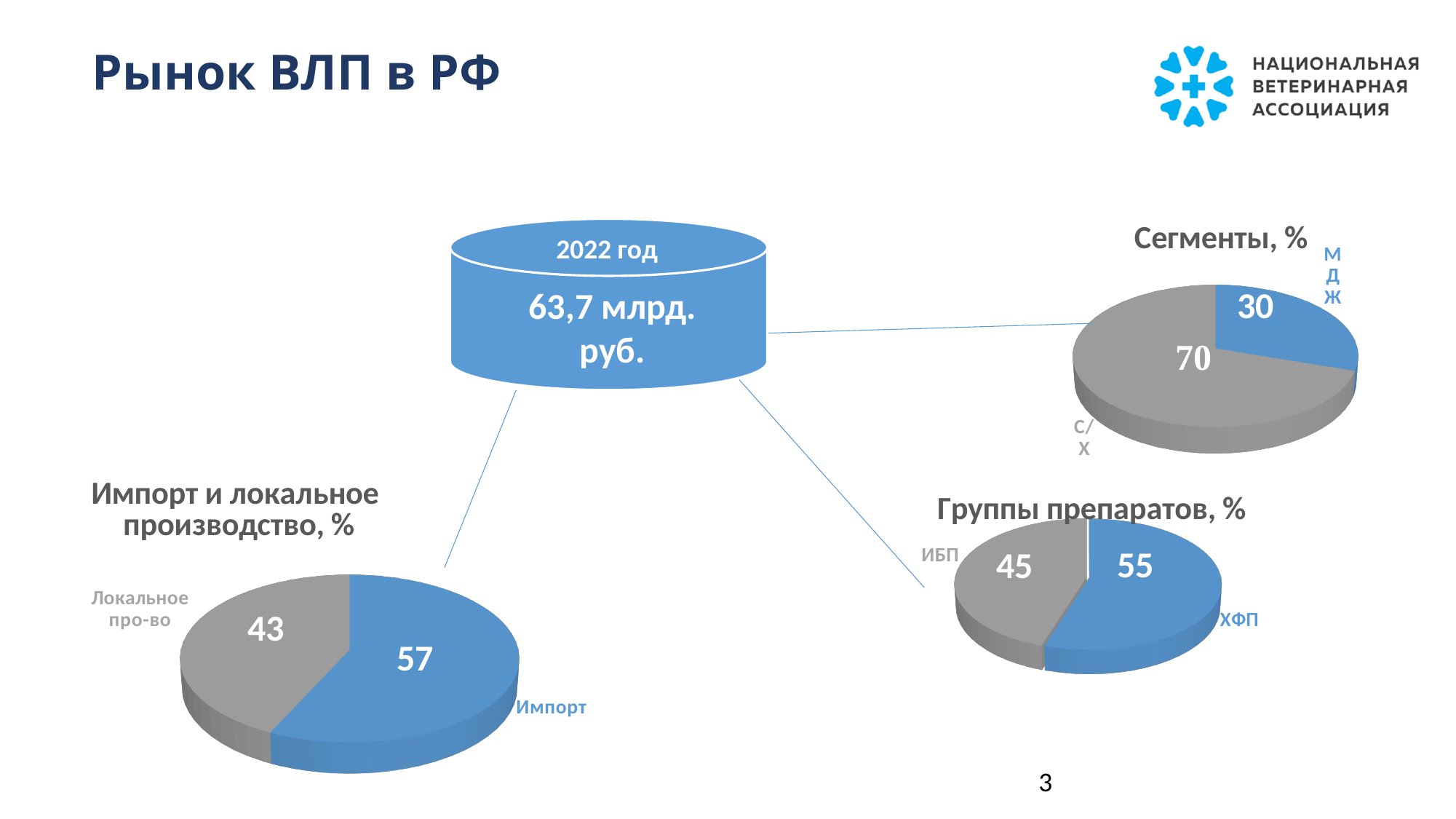
In the 'Группы препаратов, %' chart, what is the value for ХФП? 55 In the 'Группы препаратов, %' chart, which group is the smallest? ИБП In the 'Сегменты, %' chart, what is the value for С/Х? 70 In the 'Сегменты, %' chart, what is the value for МДЖ? 30 In the 'Импорт и локальное производство, %' chart, which is larger, Импорт or Локальное про-во? Импорт What kind of chart is 'Группы препаратов, %'? Pie chart In the 'Группы препаратов, %' chart, what is the value for ИБП? 45 In the 'Сегменты, %' chart, what is the difference between С/Х and МДЖ? 40 In the 'Импорт и локальное производство, %' chart, what is the value for Локальное про-во? 43 In the 'Импорт и локальное производство, %' chart, what is the difference between Импорт and Локальное про-во? 14 In the 'Импорт и локальное производство, %' chart, what is the value for Импорт? 57 In the 'Сегменты, %' chart, which segment is the largest? С/Х